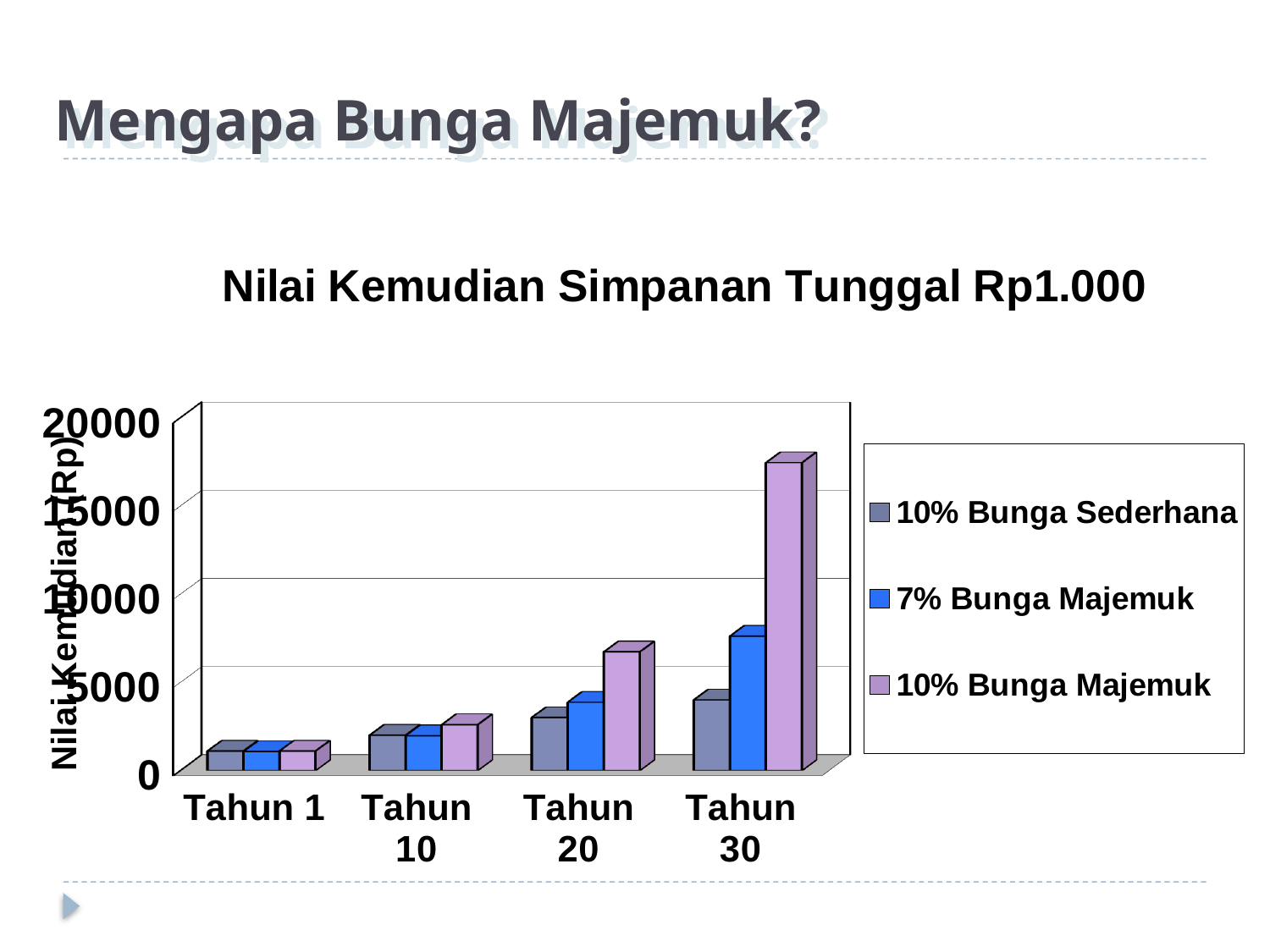
Is the value for 10% Bunga Majemuk at Tahun 20 greater or less than 5000? greater Which series has the lowest value at Tahun 30? 10% Bunga Sederhana Is the value for 10% Bunga Sederhana at Tahun 30 greater or less than 5000? less Which series has the highest value at Tahun 30? 10% Bunga Majemuk What kind of chart is shown on the slide? bar chart How many categories are shown on the x axis? 4 At Tahun 30, which is larger: 10% Bunga Majemuk or 7% Bunga Majemuk? 10% Bunga Majemuk What is the title of the chart? Nilai Kemudian Simpanan Tunggal Rp1.000 Do the values for 10% Bunga Majemuk rise or fall from Tahun 1 to Tahun 30? rise Is the value for 10% Bunga Majemuk at Tahun 30 greater or less than 15000? greater How many series does the legend list? 3